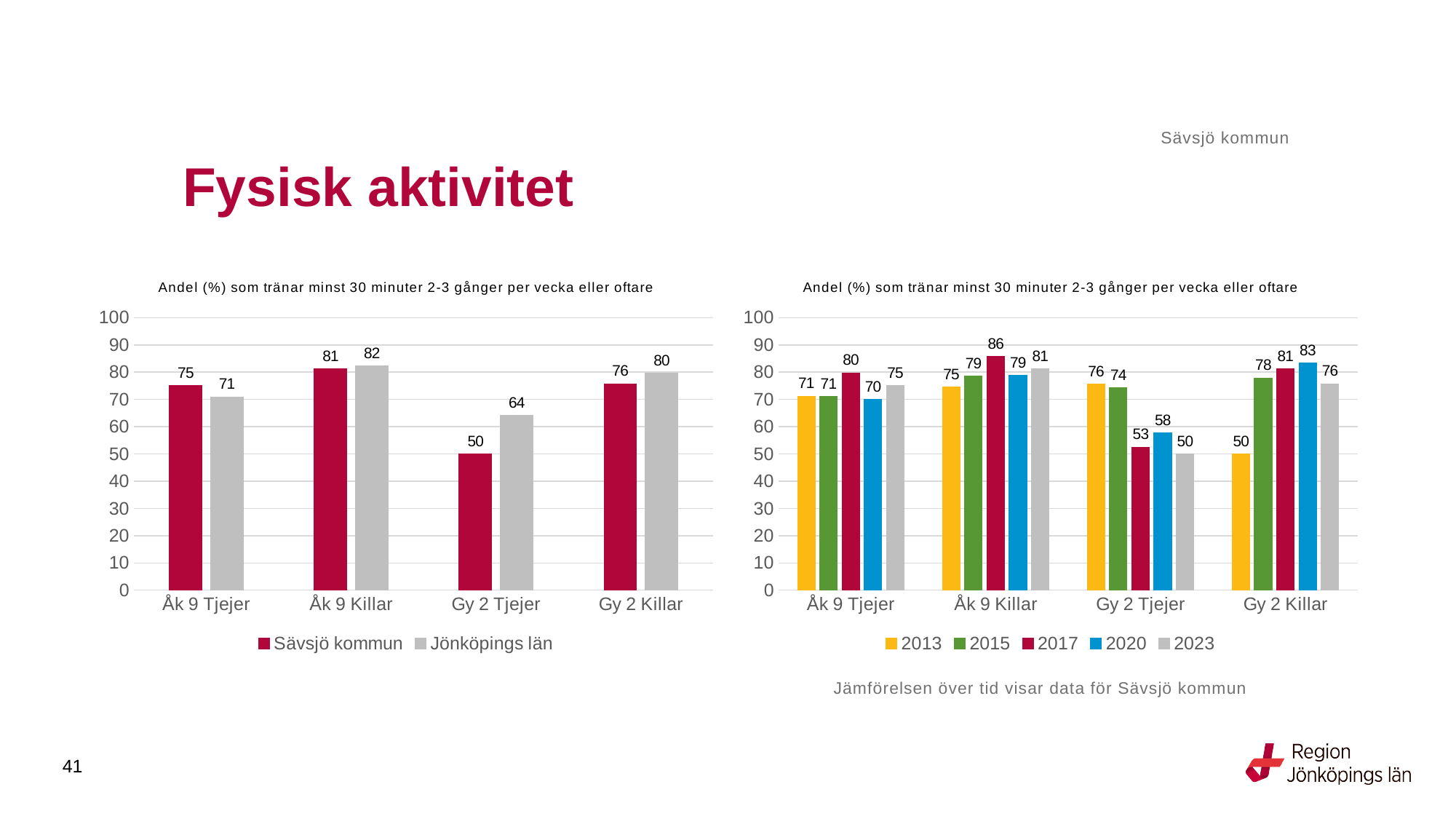
In the left chart, which category has the lowest value for Sävsjö kommun? Gy 2 Tjejer In the right chart, is the value for 2023 for Gy 2 Tjejer larger or smaller than the value for 2013 for Gy 2 Tjejer? smaller What kind of chart is the right chart? Bar chart In the left chart, what is the value for Sävsjö kommun for Gy 2 Tjejer? 50 In the right chart, how many series does the legend list? 5 In the right chart, what is the value for 2013 for Gy 2 Killar? 50 In the left chart, what is the value for Jönköpings län for Gy 2 Killar? 80 In the right chart, what is the value for 2017 for Åk 9 Killar? 86 In the right chart, how many categories are shown on the x axis? 4 In the right chart, which year has the highest value for Gy 2 Killar? 2020 In the left chart, how many series does the legend list? 2 In the left chart, what is the difference between Jönköpings län and Sävsjö kommun for Gy 2 Tjejer? 14